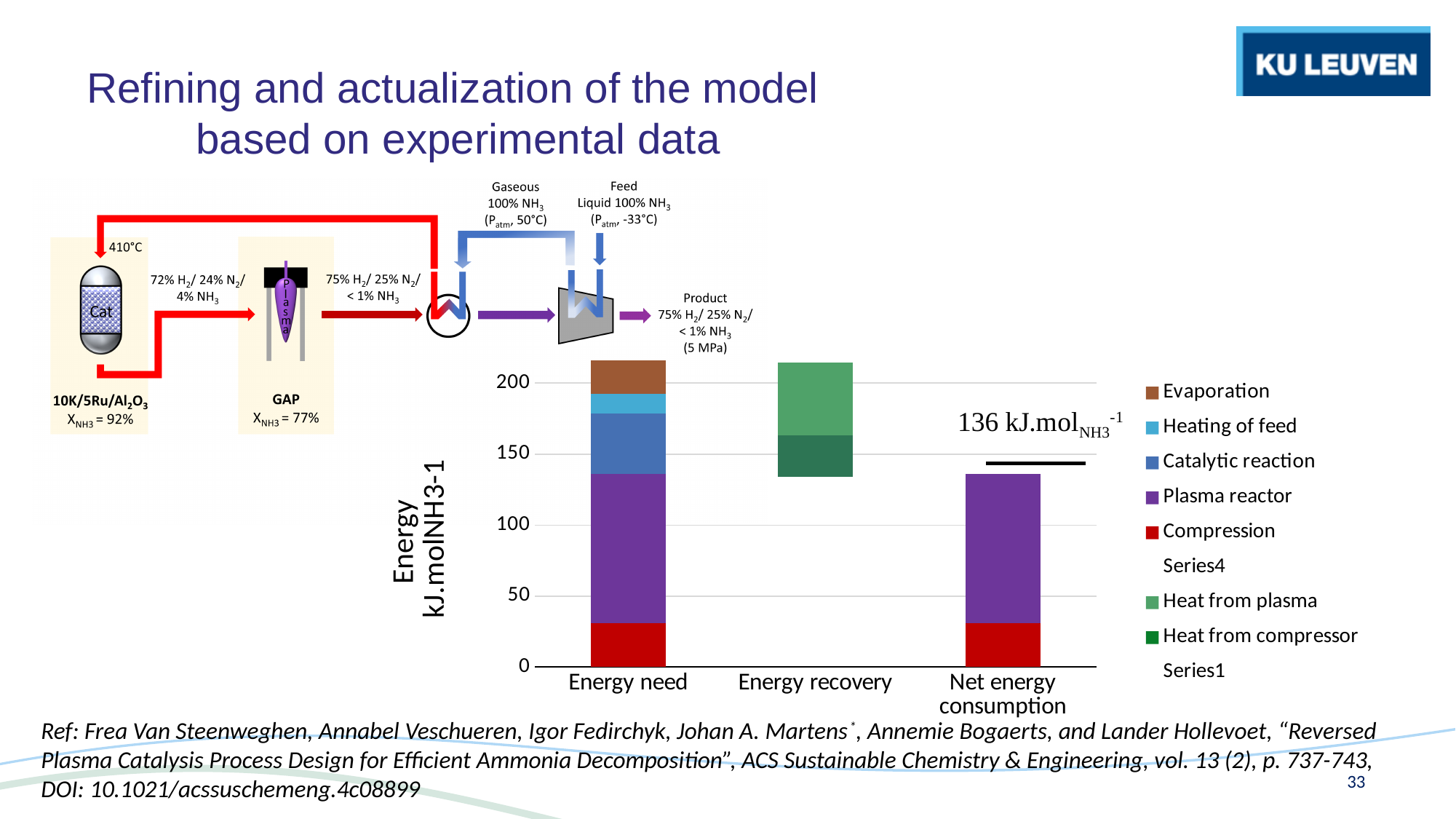
How many categories are shown on the x axis of the chart? 3 How many entries does the chart legend list? 9 What value is labelled for Net energy consumption? 136 kJ.mol NH3^-1 Is the value for Net energy consumption greater or less than 150? less Which bar is taller, Energy need or Net energy consumption? Energy need Is the top of the Plasma reactor segment in the Energy need bar greater or less than 150? less What kind of chart is shown on the slide? Stacked bar chart Is the Compression segment of the Energy need bar greater or less than 50? less What is the label of the y axis? Energy kJ.molNH3-1 Which colour represents Plasma reactor in the legend? Purple Which category has the tallest bar? Energy need